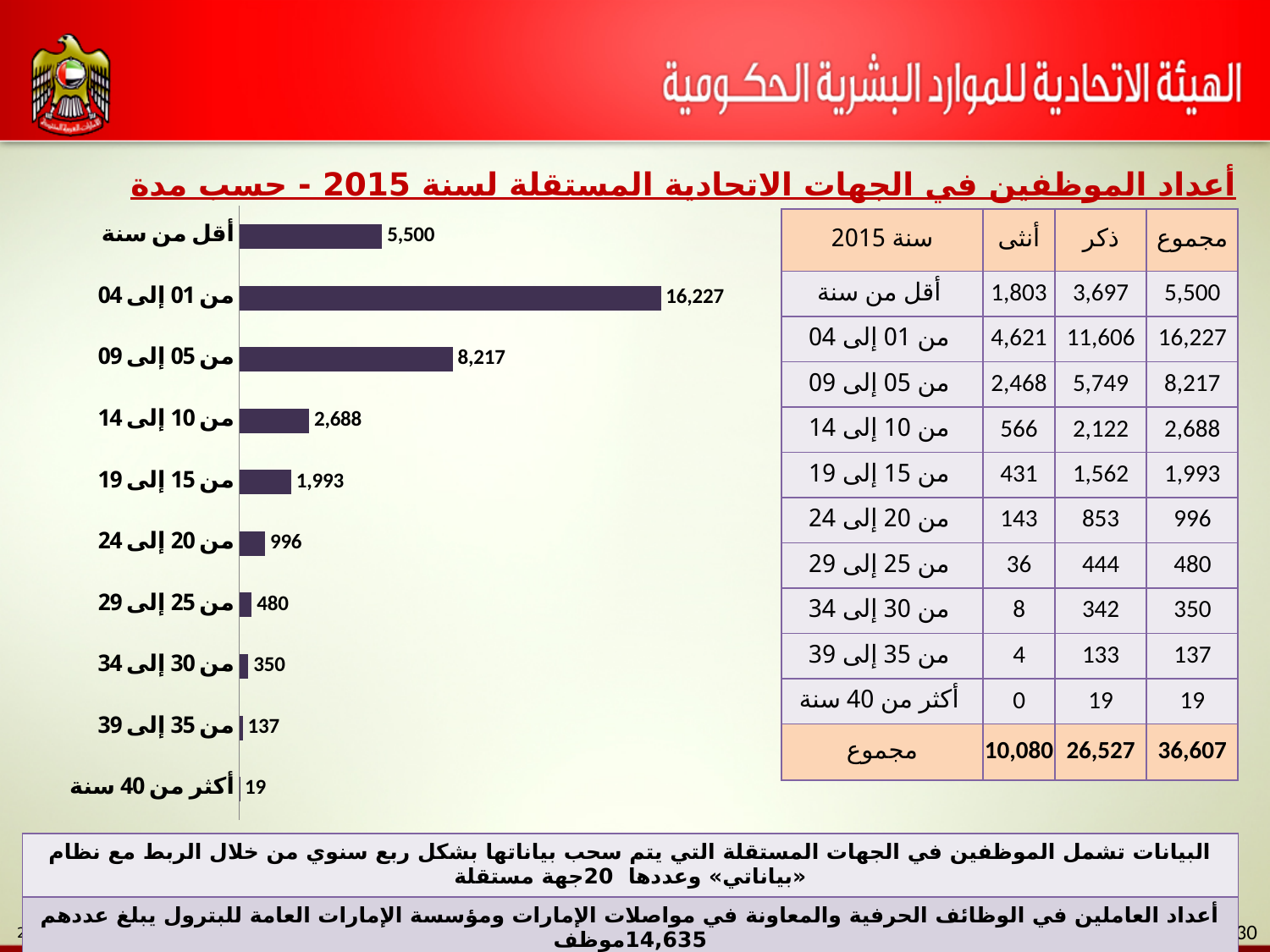
What is the value shown for the category "أقل من سنة" in the bar chart? 5,500 What is the difference between the values for "من 01 إلى 04" and "من 05 إلى 09" in the bar chart? 8,010 Do the values in the bar chart rise or fall from the category "من 01 إلى 04" down to "أكثر من 40 سنة"? Fall What is the value shown for the category "أكثر من 40 سنة" in the bar chart? 19 Which has a larger value in the bar chart, "من 25 إلى 29" or "من 30 إلى 34"? من 25 إلى 29 Which category has the highest value in the bar chart? من 01 إلى 04 What is the difference between the values for "من 15 إلى 19" and "من 20 إلى 24" in the bar chart? 997 Which category has the lowest value in the bar chart? أكثر من 40 سنة What is the value shown for the category "من 10 إلى 14" in the bar chart? 2,688 What is the value shown for the category "من 01 إلى 04" in the bar chart? 16,227 What type of chart is shown on the slide? Bar chart How many categories are shown in the bar chart? 10